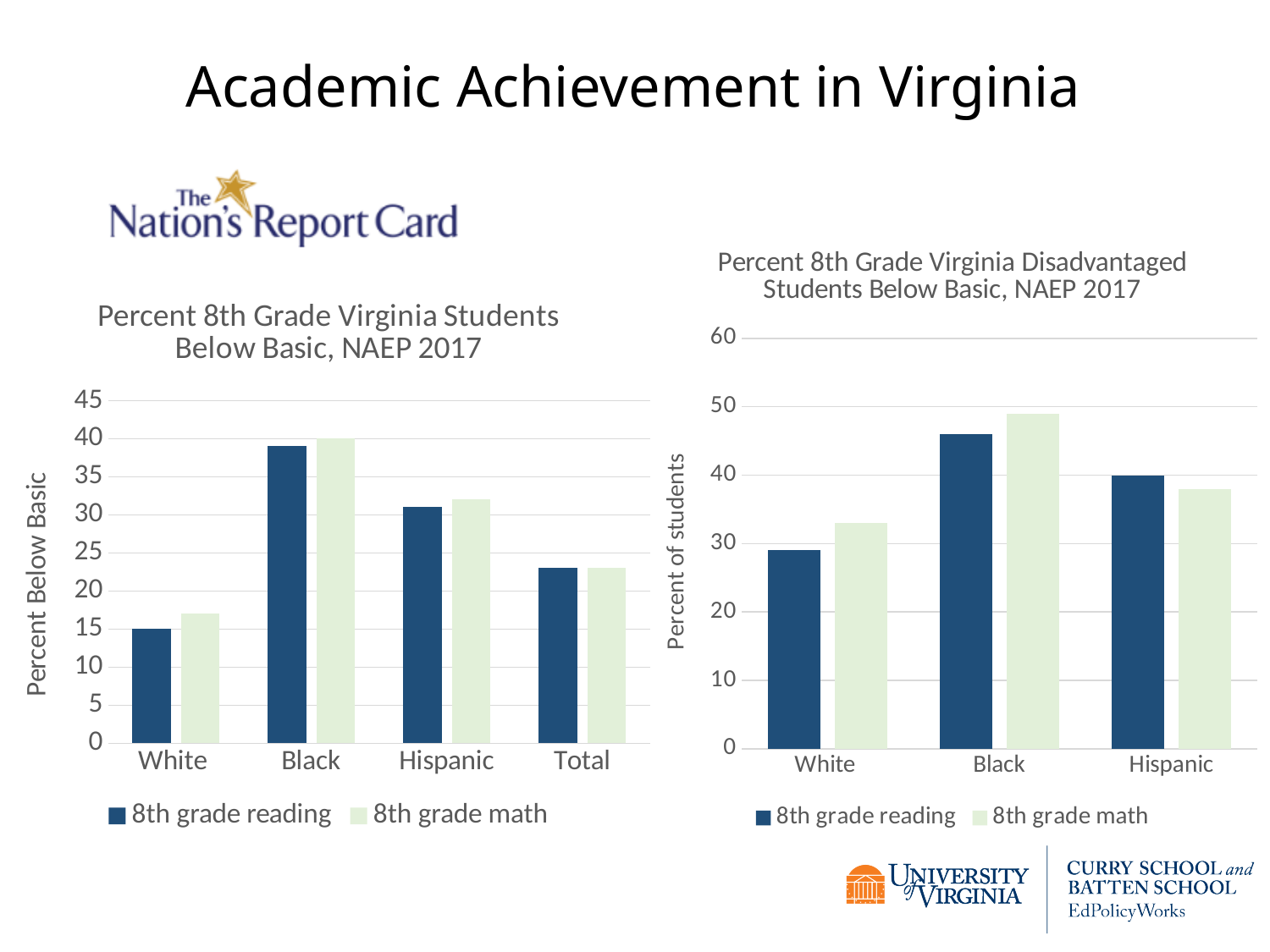
In the left chart, 'Percent 8th Grade Virginia Students Below Basic, NAEP 2017', which category has the highest 8th grade reading value? Black In the left chart, 'Percent 8th Grade Virginia Students Below Basic, NAEP 2017', how many categories are shown on the x axis? 4 In the left chart, 'Percent 8th Grade Virginia Students Below Basic, NAEP 2017', which category has the lowest 8th grade math value? White In the left chart, 'Percent 8th Grade Virginia Students Below Basic, NAEP 2017', which is larger for Hispanic students: 8th grade reading or 8th grade math? 8th grade math In the right chart, 'Percent 8th Grade Virginia Disadvantaged Students Below Basic, NAEP 2017', is the 8th grade math value for White greater or less than 30? greater In the left chart, 'Percent 8th Grade Virginia Students Below Basic, NAEP 2017', is the 8th grade math value for Total greater or less than 25? less In the right chart, 'Percent 8th Grade Virginia Disadvantaged Students Below Basic, NAEP 2017', which category has the lowest 8th grade reading value? White What type of chart is the right chart, 'Percent 8th Grade Virginia Disadvantaged Students Below Basic, NAEP 2017'? Bar chart In the left chart, 'Percent 8th Grade Virginia Students Below Basic, NAEP 2017', is the 8th grade reading value for Black greater or less than 35? greater In the right chart, 'Percent 8th Grade Virginia Disadvantaged Students Below Basic, NAEP 2017', which is larger for Hispanic students: 8th grade reading or 8th grade math? 8th grade reading In the right chart, 'Percent 8th Grade Virginia Disadvantaged Students Below Basic, NAEP 2017', which category has the highest 8th grade math value? Black In the right chart, 'Percent 8th Grade Virginia Disadvantaged Students Below Basic, NAEP 2017', how many series does the legend list? 2